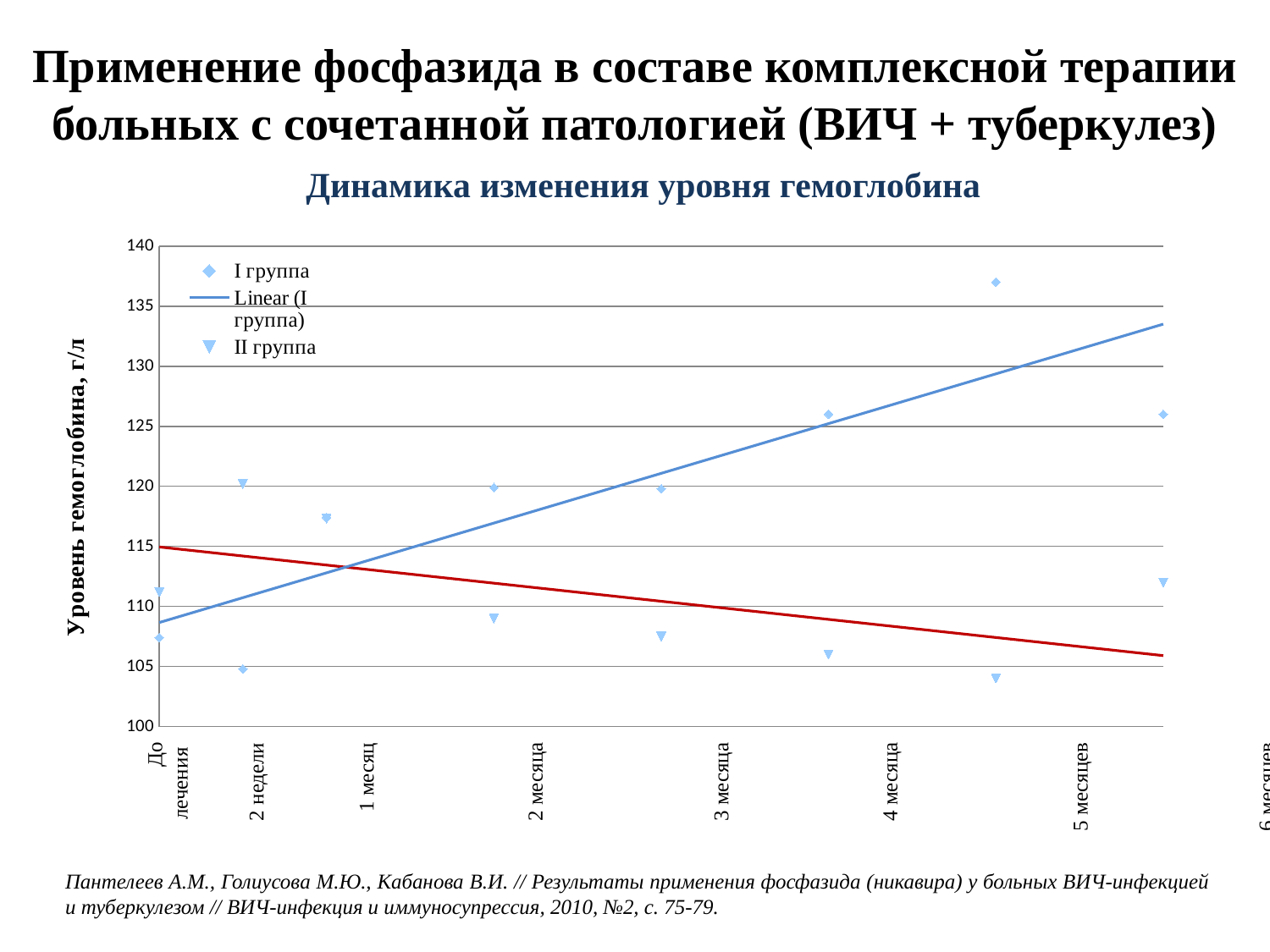
Is the value for II группа at '4 месяца' greater or less than 110? less How many entries does the chart legend list? 3 Is the value for I группа at 'До лечения' greater or less than 110? less At '4 месяца', which group has the higher hemoglobin value, I группа or II группа? I группа Does the red linear trend line for II группа rise or fall from left to right? falls What kind of chart is shown on the slide? scatter chart Is the value for II группа at '2 месяца' greater or less than 110? less What is the label of the vertical axis? Уровень гемоглобина, г/л Which group has the highest plotted point on the chart? I группа Does the linear trend line for I группа rise or fall from left to right? rises What is the title of the chart? Динамика изменения уровня гемоглобина